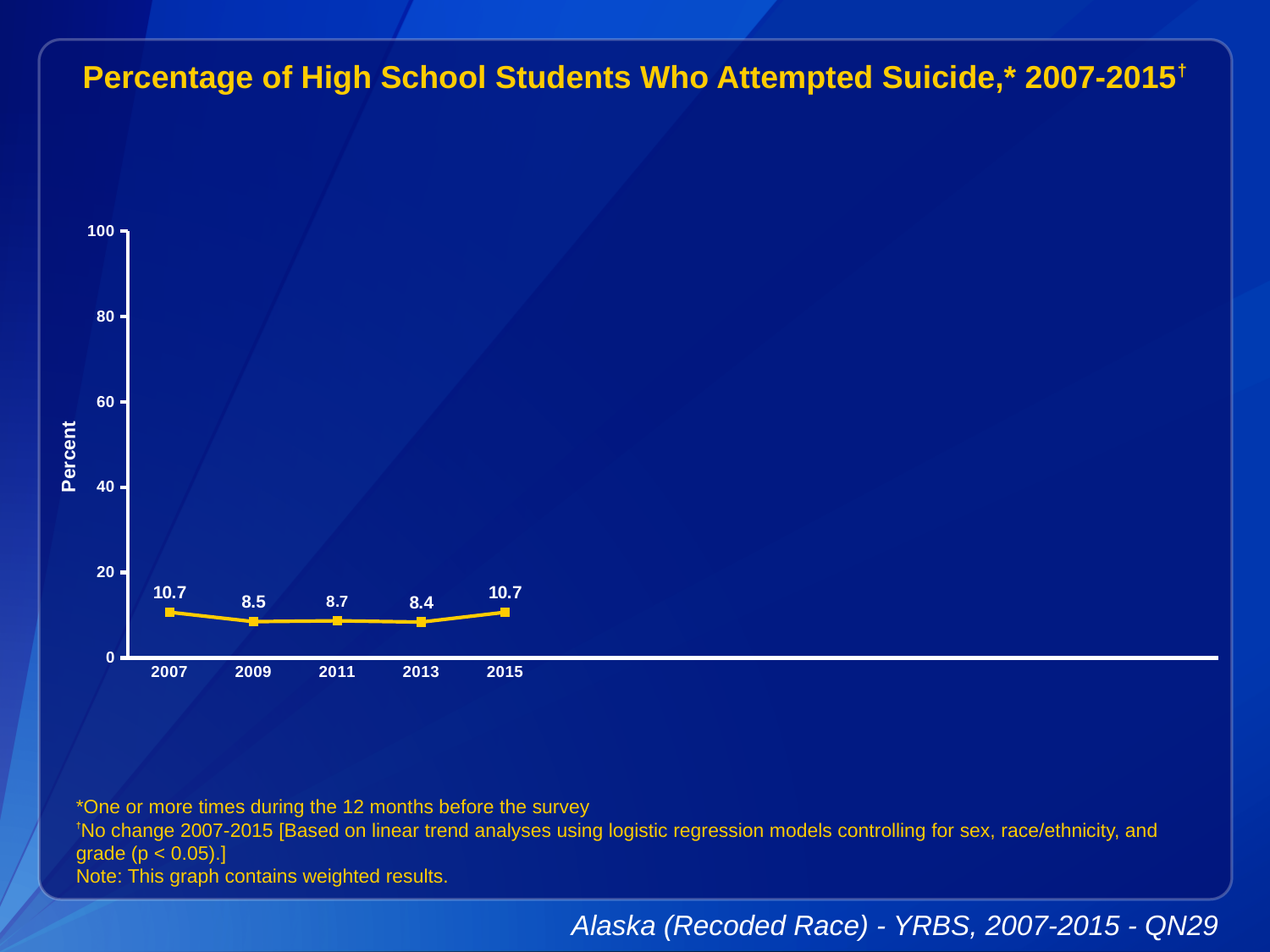
What kind of chart is shown? line chart Is the value for 2015 greater or less than 20? less What is the value for 2015? 10.7 What is the value for 2011? 8.7 What is the value for 2007? 10.7 Which is larger, the value for 2011 or the value for 2013? 2011 What is the value for 2009? 8.5 What is the label on the y axis? Percent How many years are plotted on the chart? 5 What is the difference between the values for 2007 and 2009? 2.2 What is the value for 2013? 8.4 Which year has the lowest value? 2013